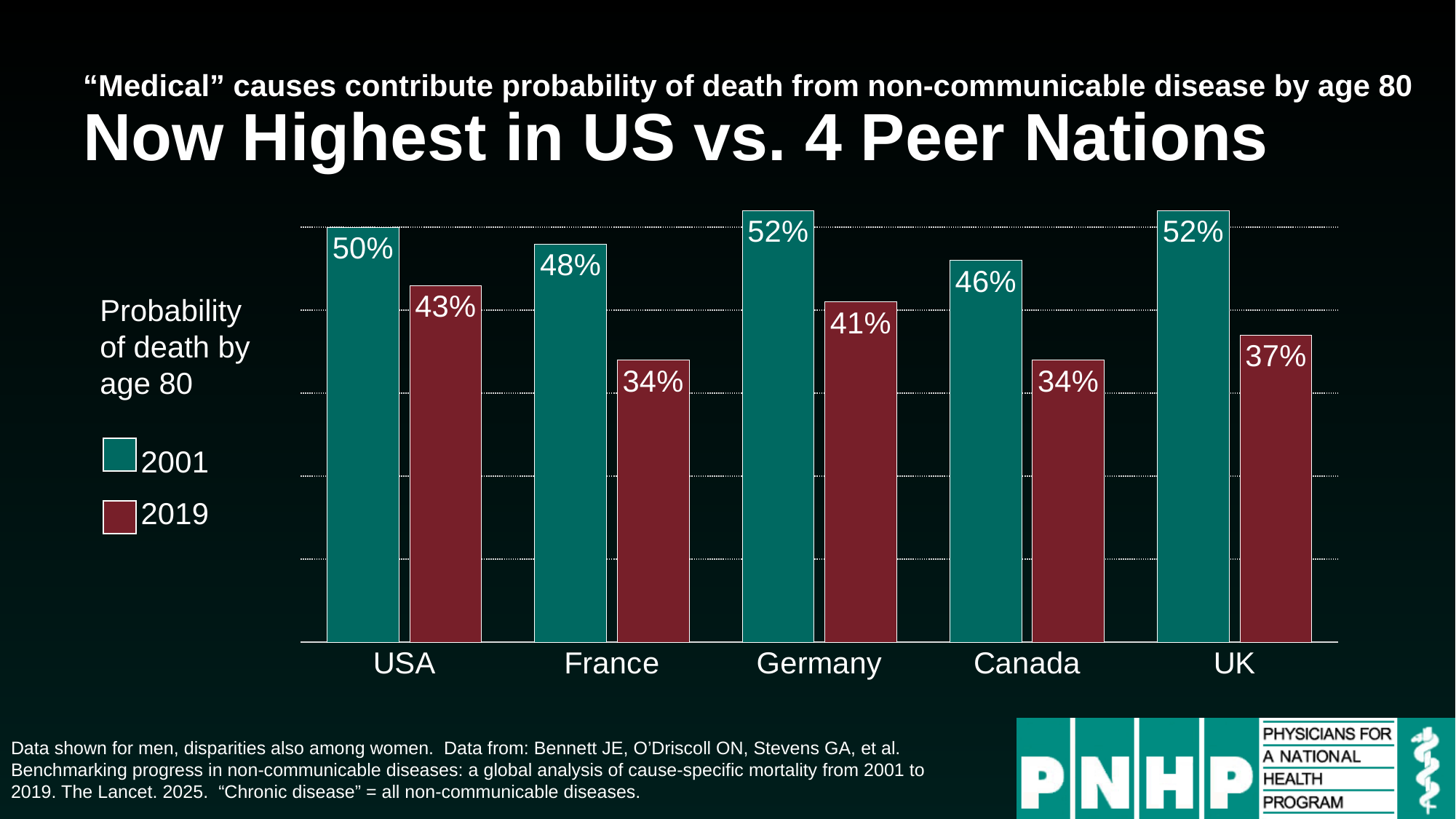
Which is larger, the 2019 value for Germany or the 2019 value for the UK? Germany How many countries are shown on the x axis? 5 Which country has the lowest 2001 value? Canada Which country has the highest 2019 value? USA How many series does the legend list? 2 Which colour represents the 2019 series in the legend? Dark red What is the 2019 value for the USA? 43% What is the 2001 value for Canada? 46% What is the difference between the 2001 and 2019 values for France? 14% What is the 2019 value for the UK? 37% What kind of chart is shown on the slide? Bar chart What is the 2001 value for Germany? 52%